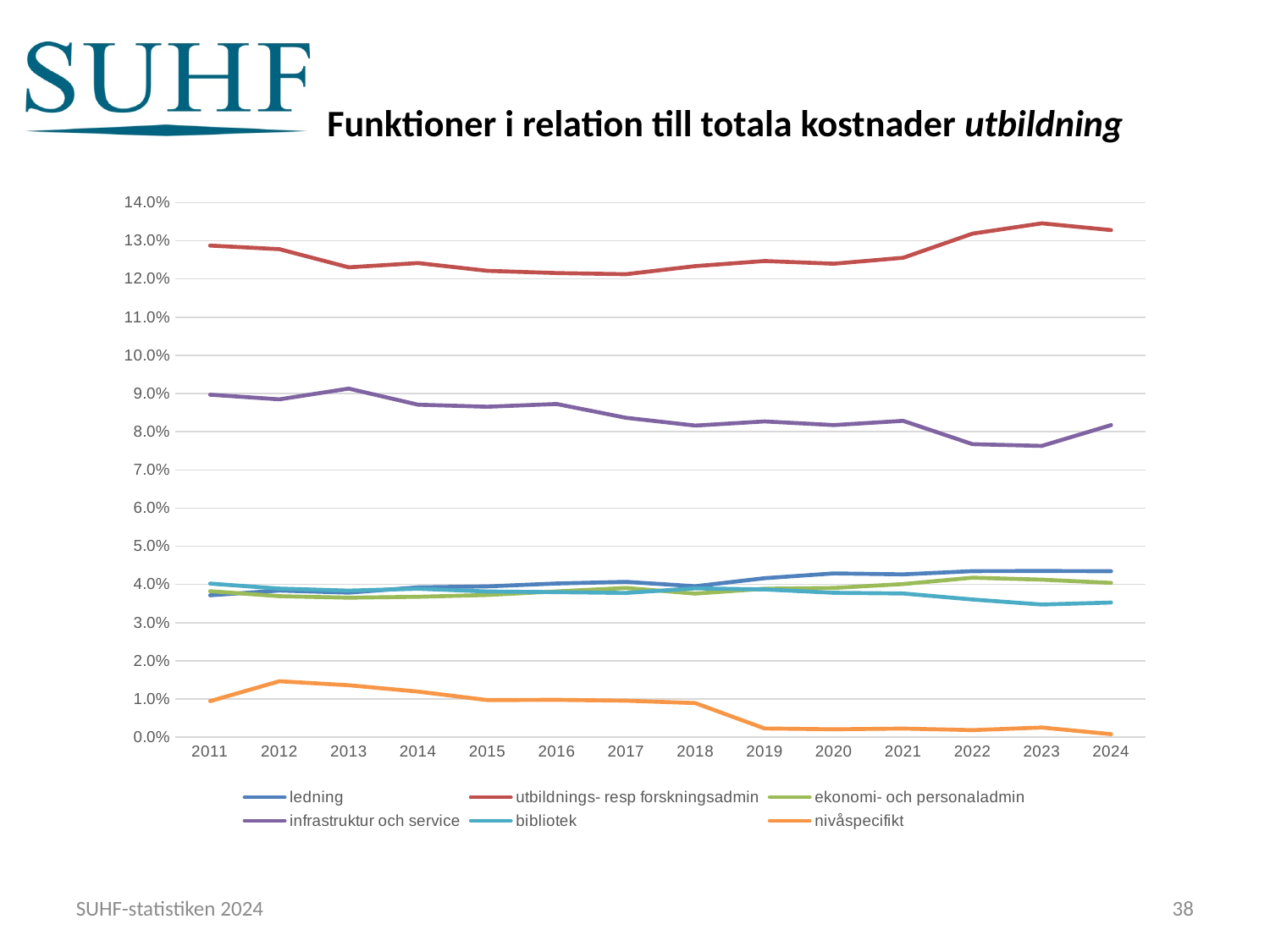
What kind of chart is shown on the slide? line chart Is the value for nivåspecifikt in 2024 greater or less than 1.0%? less Is the value for utbildnings- resp forskningsadmin in 2024 greater or less than 13.0%? greater What is the title of the chart? Funktioner i relation till totala kostnader utbildning In 2024, which is larger: infrastruktur och service or ledning? infrastruktur och service Is the value for nivåspecifikt in 2012 greater or less than 1.0%? greater Which series has the highest values across all years? utbildnings- resp forskningsadmin Does the nivåspecifikt series rise or fall from 2012 to 2024? fall Which series has the lowest values across all years? nivåspecifikt How many years are shown along the x axis? 14 How many series does the legend list? 6